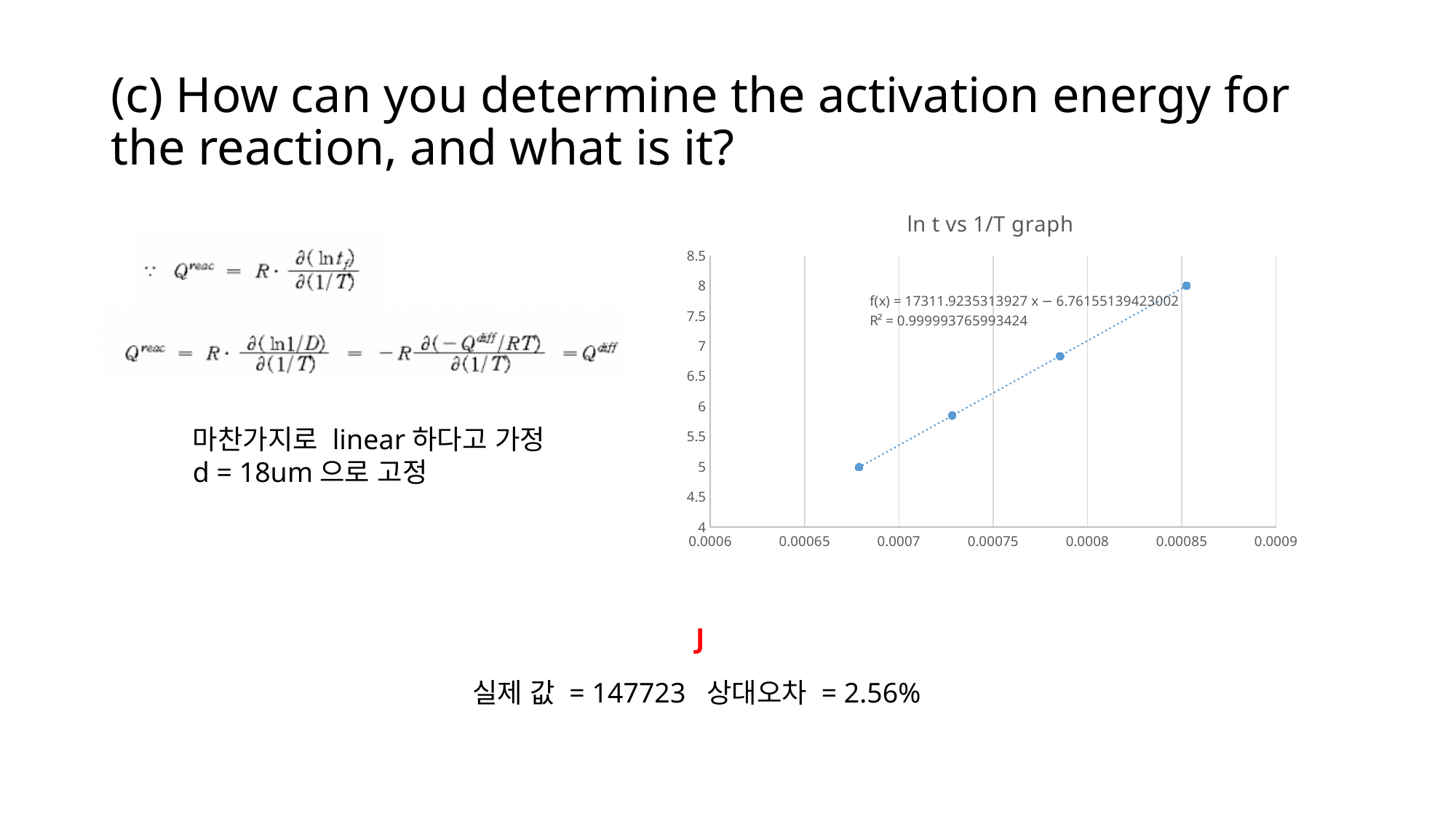
What is the maximum value shown on the y axis of the chart? 8.5 What kind of chart is shown on the slide? scatter chart Is the value of the leftmost data point greater or less than 5.5? less What is the trendline equation printed on the chart? f(x) = 17311.9235313927 x − 6.76155139423002 Is the value of the third data point from the left greater or less than 6? greater Is the value of the rightmost data point greater or less than 7.5? greater Which data point has the highest ln t value: the one with the largest 1/T or the one with the smallest 1/T? the one with the largest 1/T Do the plotted values rise or fall as 1/T increases along the x axis? rise Is the value of the data point with the smallest 1/T larger or smaller than the value of the data point with the largest 1/T? smaller What is the title of the chart? ln t vs 1/T graph How many data points are plotted in the 'ln t vs 1/T graph' chart? 4